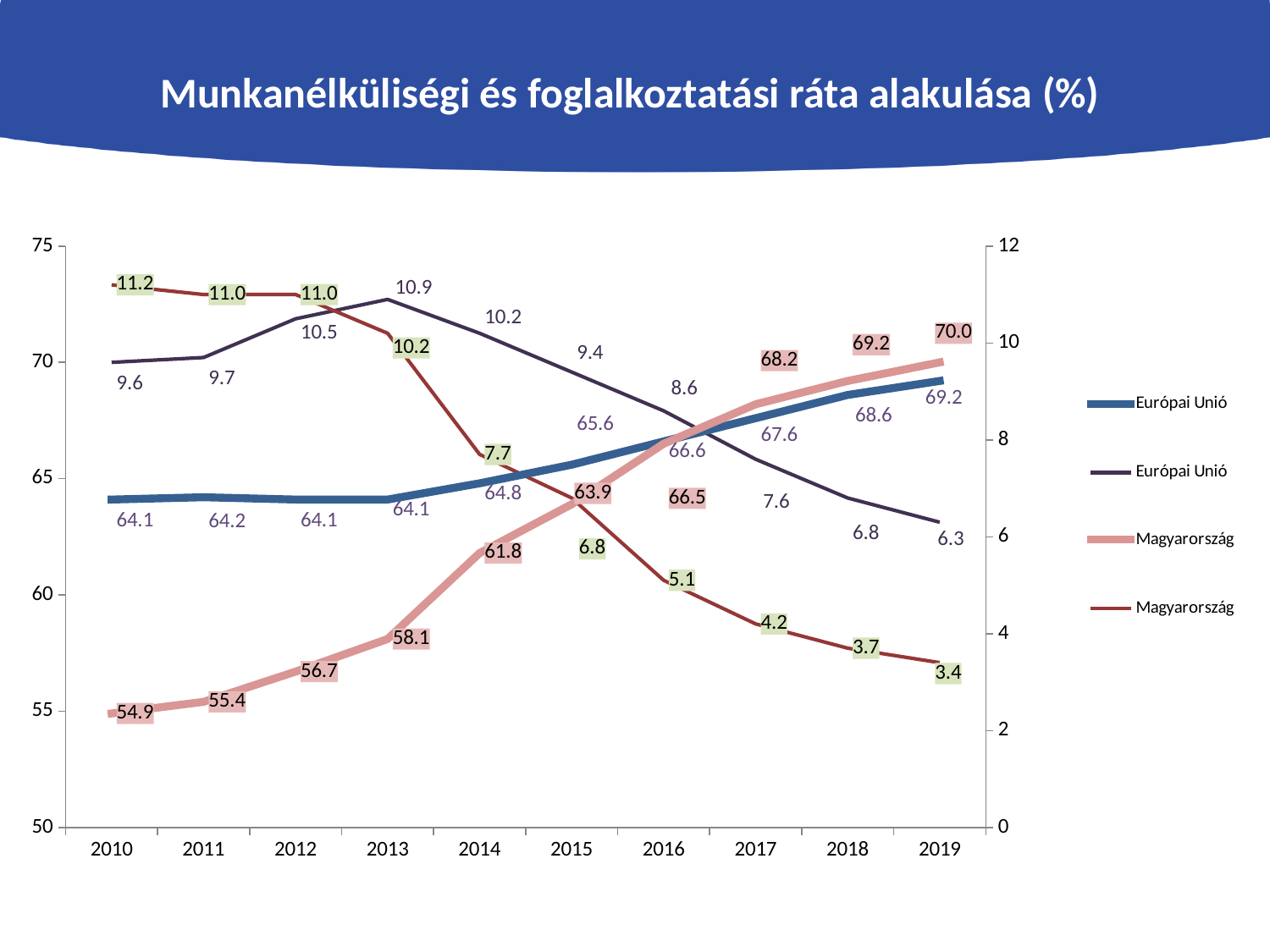
In 2017, which is larger: the thick pink Magyarország line or the thick blue Európai Unió line? the thick pink Magyarország line How many series does the legend list? 4 What is the difference between the thin red Magyarország line's values in 2010 and 2019? 7.8 In which year is the thick pink Magyarország line at its lowest value? 2010 What type of chart is shown on the slide? line chart Does the thin red Magyarország line rise or fall from 2013 to 2019? fall How many years are shown on the x axis? 10 What is the value of the thick blue Európai Unió line in 2016? 66.6 What is the title of the chart? Munkanélküliségi és foglalkoztatási ráta alakulása (%) What is the value of the thick pink Magyarország line in 2019? 70.0 What is the value of the thin red Magyarország line in 2014? 7.7 In which year does the thin dark Európai Unió line reach its highest value? 2013